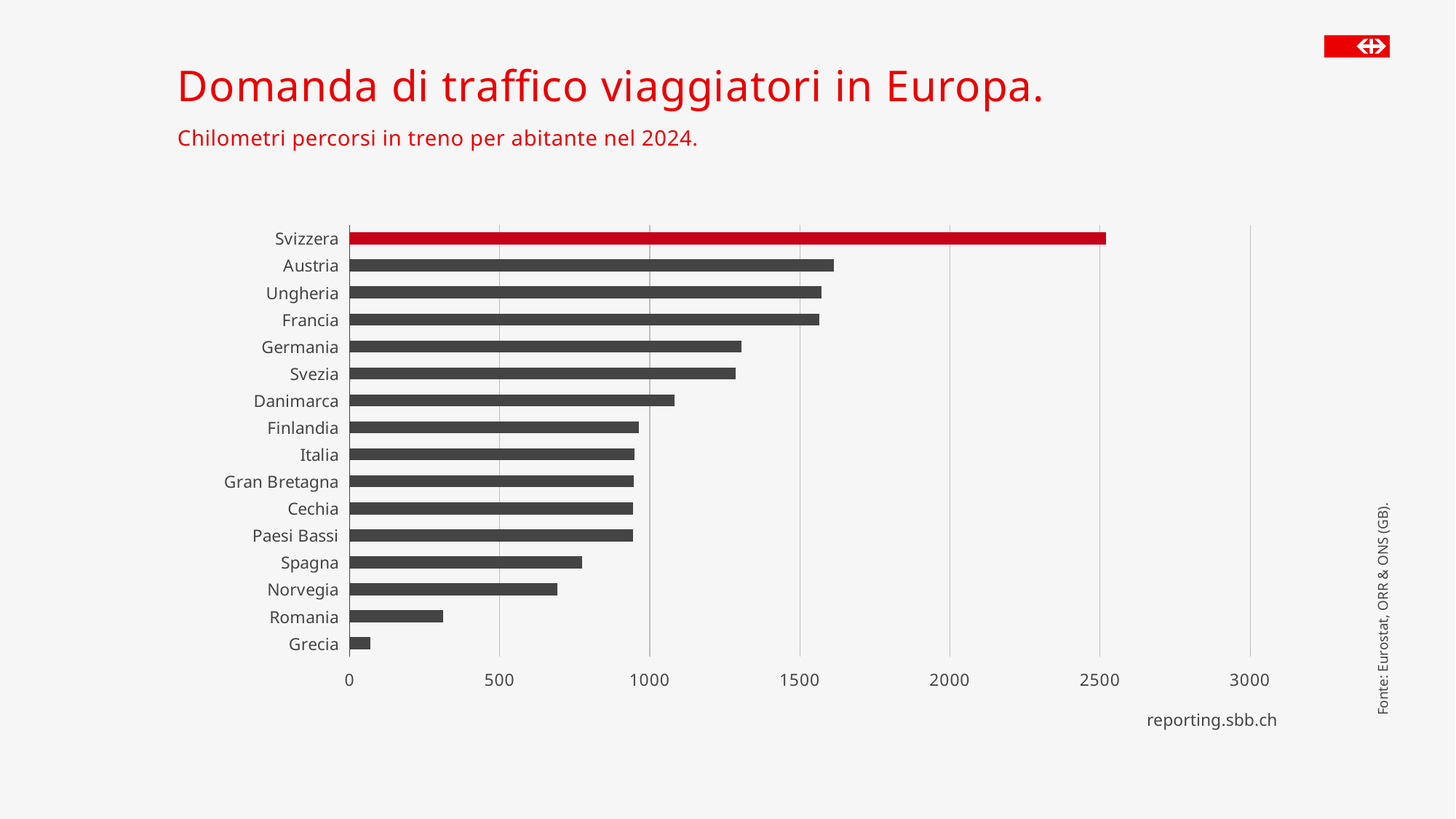
What kind of chart is shown on the slide? bar chart Is the value for Svizzera greater or less than 2000? greater How many countries are shown in the chart? 16 Which has a larger value, Germania or Danimarca? Germania Which country has the lowest value in the chart? Grecia Is the value for Romania greater or less than 500? less Is the value for Germania greater or less than 1500? less Which bar is drawn in red rather than dark grey? Svizzera Which has a larger value, Norvegia or Romania? Norvegia Which country has the highest value in the chart? Svizzera